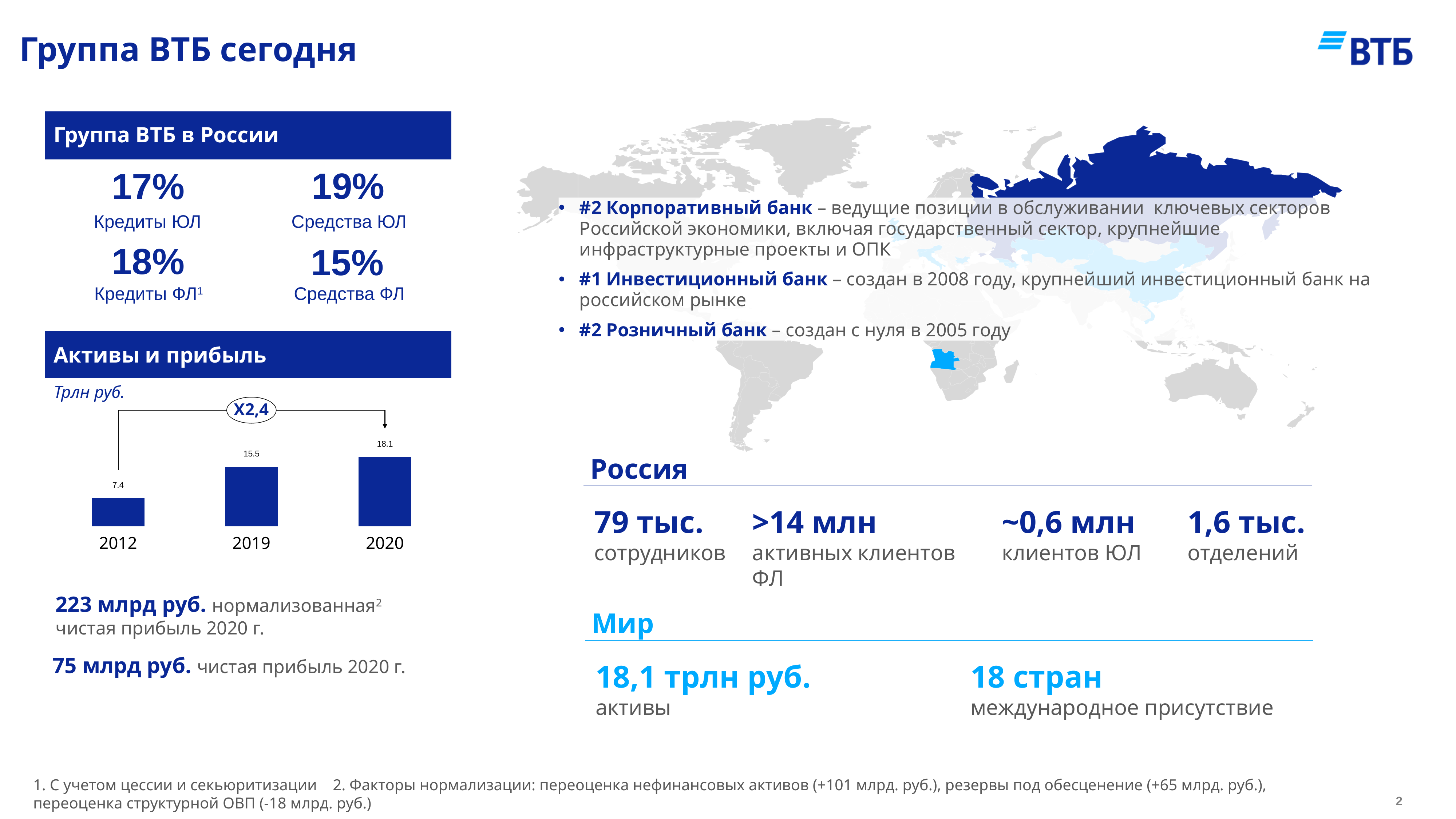
In the "Активы и прибыль" chart, what is the value for 2012? 7.4 In the "Активы и прибыль" chart, what is the difference between the 2020 and 2019 values? 2.6 What unit is indicated for the "Активы и прибыль" chart? Трлн руб. Do the values in the "Активы и прибыль" chart rise or fall from 2012 to 2020? rise In the "Активы и прибыль" chart, which is larger: the value for 2019 or the value for 2012? 2019 How many bars are in the "Активы и прибыль" chart? 3 In the "Активы и прибыль" chart, what is the value for 2020? 18.1 In the "Активы и прибыль" chart, what is the value for 2019? 15.5 In the "Активы и прибыль" chart, what is the difference between the 2020 and 2012 values? 10.7 In the "Активы и прибыль" chart, which year has the lowest value? 2012 What type of chart is shown under "Активы и прибыль"? bar chart In the "Активы и прибыль" chart, which year has the highest value? 2020